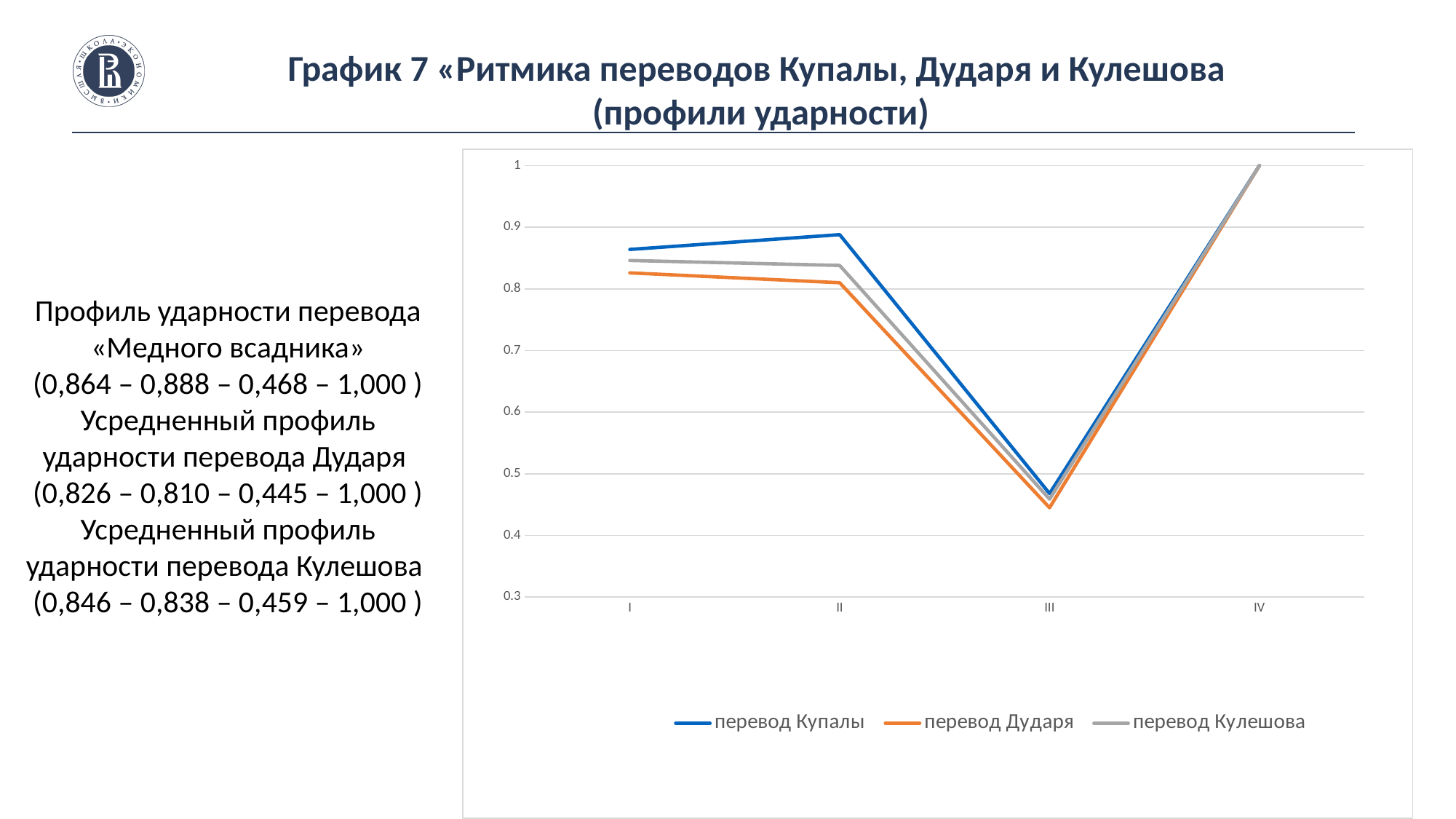
Is the value for перевод Купалы at point II greater or less than 0.8? greater How many series does the chart legend list? 3 Do the values for перевод Кулешова rise or fall from point II to point III? fall What kind of chart is shown on the slide? line chart How many points are on the x axis of the chart? 4 At point I, which series has the higher value: перевод Купалы or перевод Дударя? перевод Купалы What value do all three series reach at point IV? 1 At which x-axis point is the value for перевод Купалы lowest? III According to the text on the slide, what is the value of the averaged stress profile of перевод Дударя at the second position? 0,810 At which x-axis point is the value for перевод Дударя highest? IV Which series is shown in orange in the chart? перевод Дударя Is the value for перевод Дударя at point III greater or less than 0.5? less